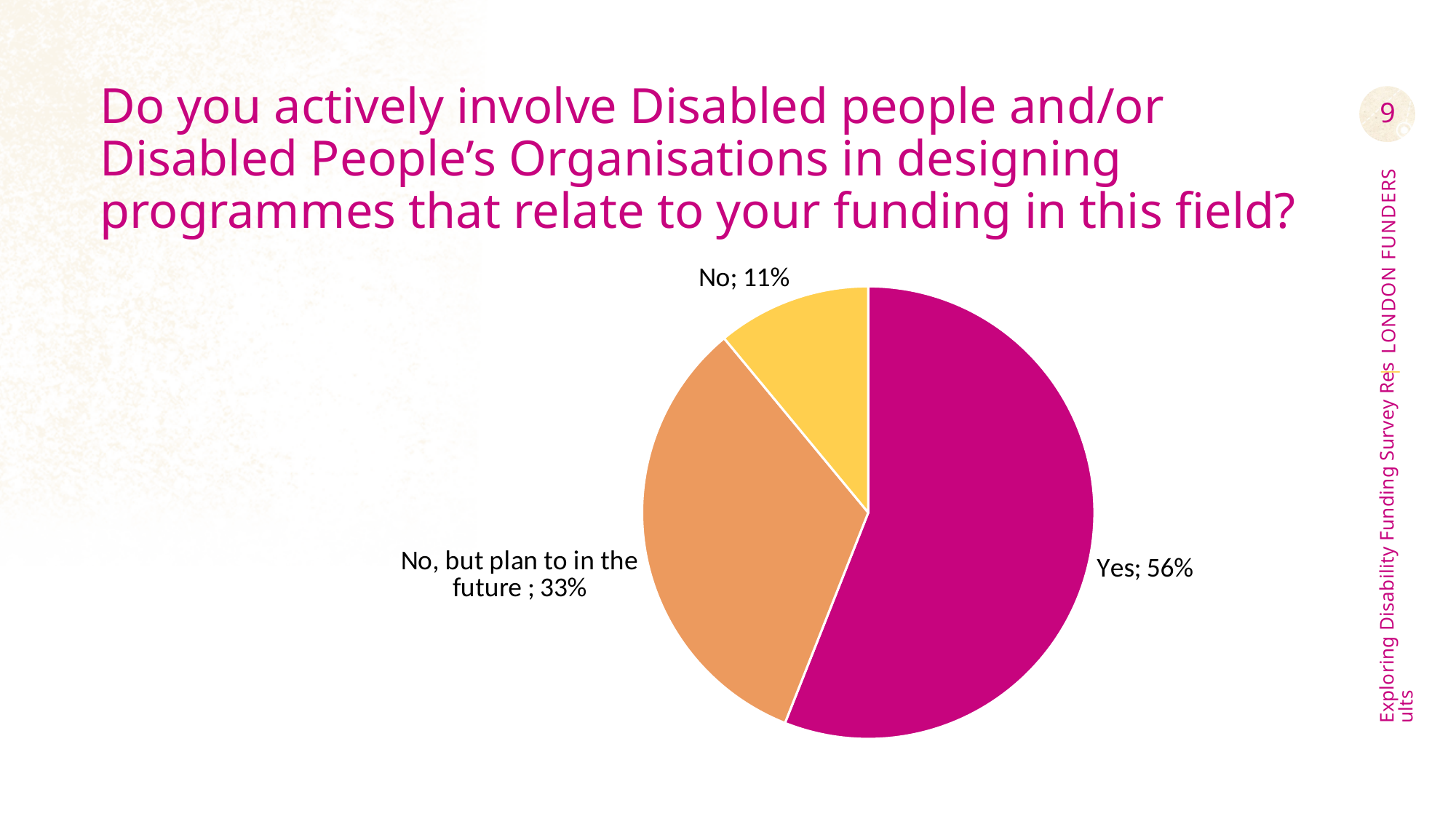
Which response has the smallest share of the pie? No Which response has the largest share of the pie? Yes What is the difference in percentage points between "Yes" and "No, but plan to in the future"? 23 What percentage of respondents answered "No"? 11% What colour is the "Yes" slice of the pie? magenta Which is larger, the share for "No" or the share for "No, but plan to in the future"? No, but plan to in the future How many slices does the pie chart have? 3 What kind of chart is shown on the slide? pie chart What colour is the "No" slice of the pie? yellow What is the difference in percentage points between "No, but plan to in the future" and "No"? 22 What percentage of respondents answered "No, but plan to in the future"? 33% What percentage of respondents answered "Yes"? 56%